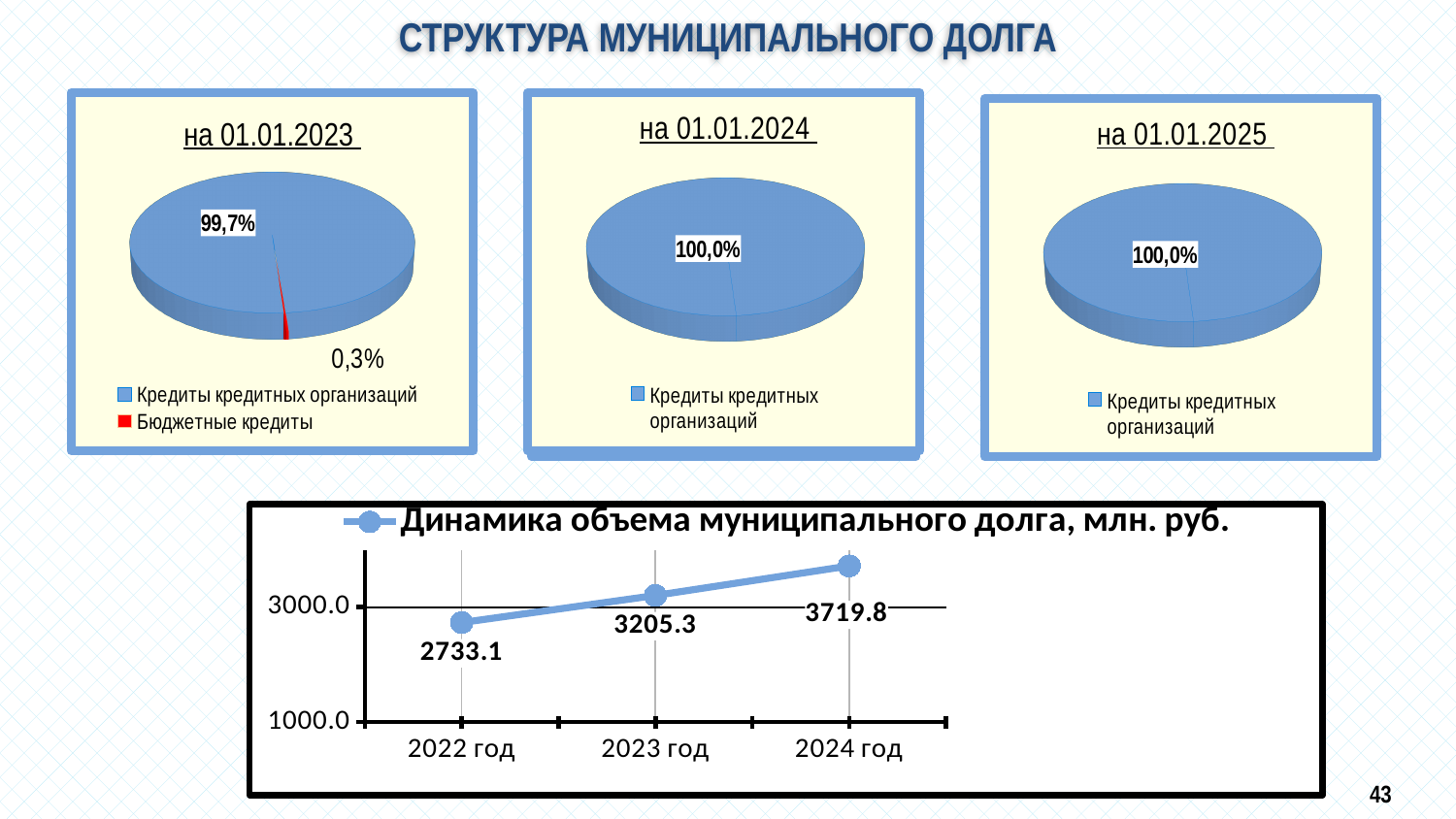
In the line chart 'Динамика объема муниципального долга, млн. руб.', which year has the highest value? 2024 год In the line chart 'Динамика объема муниципального долга, млн. руб.', is the value for 2022 год greater or less than 3000.0? less In the line chart 'Динамика объема муниципального долга, млн. руб.', which year has the lowest value? 2022 год In the pie chart 'на 01.01.2023', what share is labelled for Бюджетные кредиты? 0,3% In the line chart 'Динамика объема муниципального долга, млн. руб.', what is the value for 2022 год? 2733.1 In the line chart 'Динамика объема муниципального долга, млн. руб.', what is the difference between the values for 2024 год and 2023 год? 514.5 In the line chart 'Динамика объема муниципального долга, млн. руб.', how many data points are plotted? 3 In the line chart 'Динамика объема муниципального долга, млн. руб.', what is the value for 2024 год? 3719.8 In the pie chart 'на 01.01.2023', what share is labelled for Кредиты кредитных организаций? 99,7% How many legend entries does the pie chart 'на 01.01.2023' list? 2 In the pie chart 'на 01.01.2025', what share is labelled for Кредиты кредитных организаций? 100,0% In the line chart 'Динамика объема муниципального долга, млн. руб.', do the values rise or fall from 2022 год to 2024 год? rise